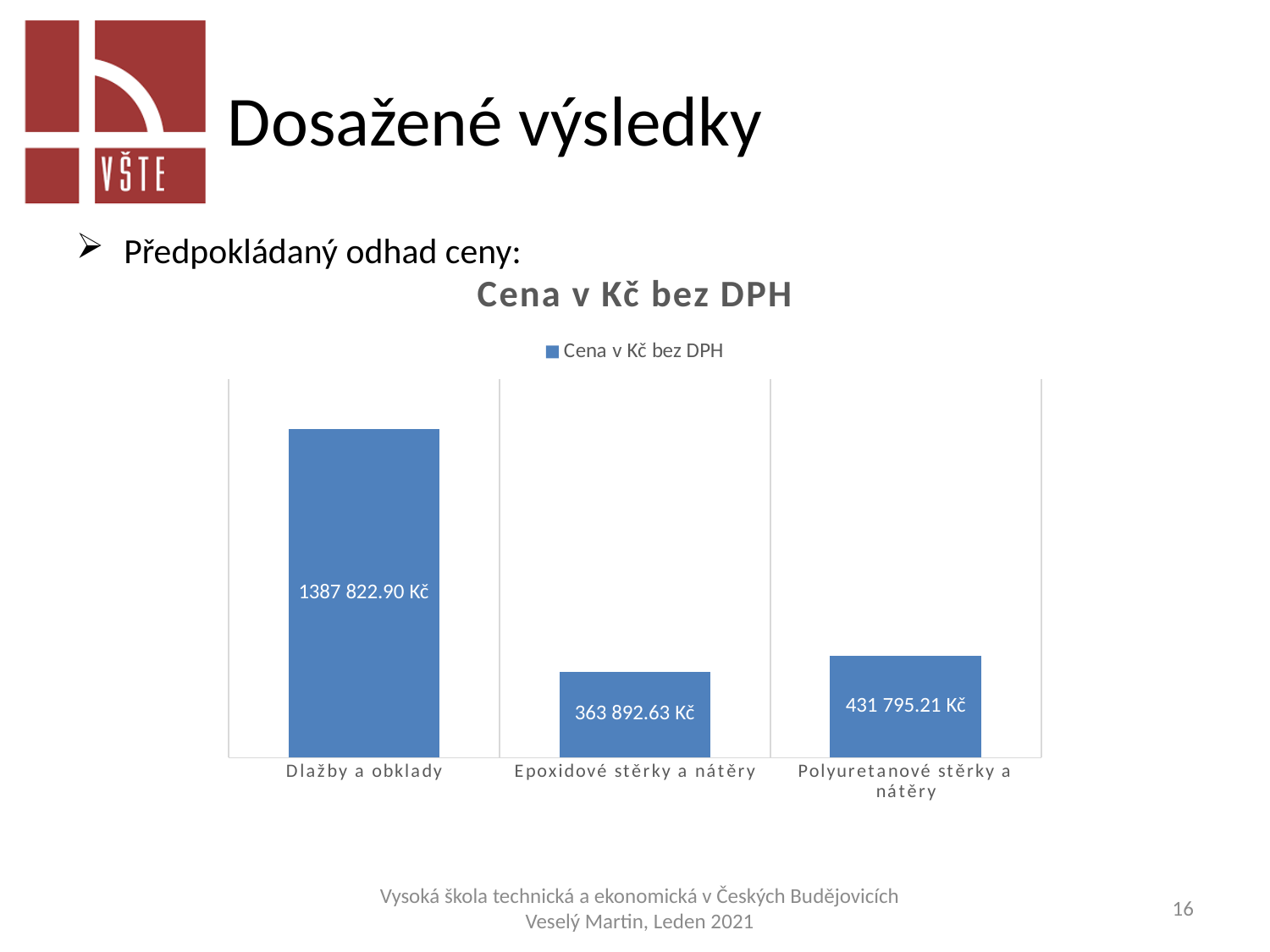
What is the difference between the values for Polyuretanové stěrky a nátěry and Epoxidové stěrky a nátěry? 67 902.58 Kč What is the title of the chart? Cena v Kč bez DPH How many series does the legend list? 1 What kind of chart is shown on the slide? Bar chart What is the value for Dlažby a obklady? 1387 822.90 Kč What is the difference between the values for Dlažby a obklady and Epoxidové stěrky a nátěry? 1 023 930.27 Kč How many categories are shown in the chart? 3 Which category has the lowest value? Epoxidové stěrky a nátěry Which is larger, the value for Epoxidové stěrky a nátěry or Polyuretanové stěrky a nátěry? Polyuretanové stěrky a nátěry Which category has the highest value? Dlažby a obklady What is the value for Epoxidové stěrky a nátěry? 363 892.63 Kč What is the value for Polyuretanové stěrky a nátěry? 431 795.21 Kč